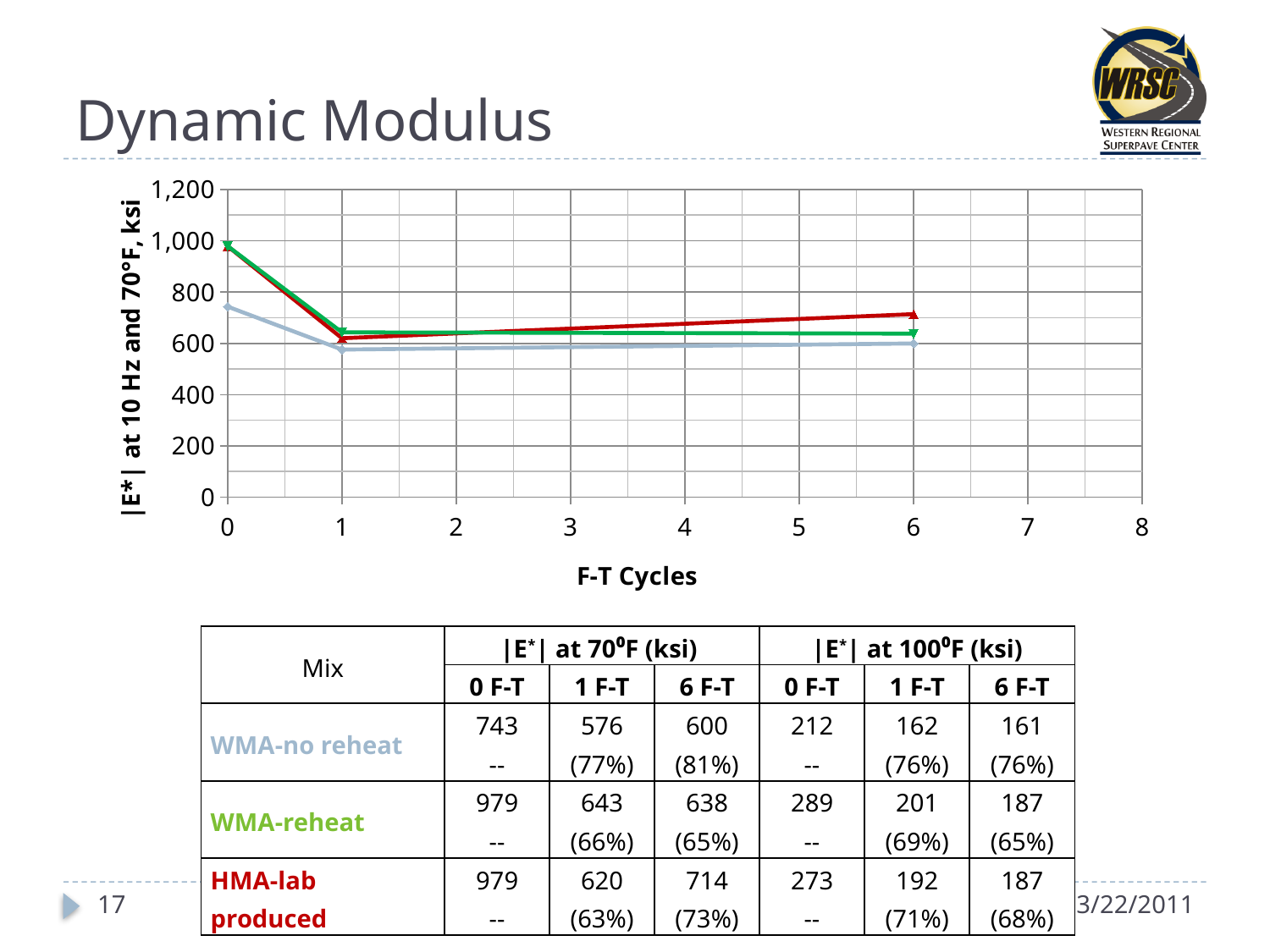
Which line has the highest value at 6 F-T cycles on the chart? the red line (HMA-lab produced) Which line has the lowest value at 1 F-T cycle on the chart? the light blue line (WMA-no reheat) What is the highest tick value shown on the y-axis of the chart? 1,200 What is the x-axis title of the chart? F-T Cycles According to the table, what is |E*| at 70°F for WMA-no reheat at 0 F-T? 743 Is the value of the light blue line at 0 F-T cycles greater or less than 800? less How many lines are plotted on the chart? 3 Is the value of the red line at 6 F-T cycles greater or less than 600? greater What kind of chart is shown on the slide? line chart What is the difference in |E*| at 70°F at 6 F-T between HMA-lab produced and WMA-reheat? 76 Do the plotted values rise or fall between 0 and 1 F-T cycles? fall According to the table, what is |E*| at 70°F for HMA-lab produced at 6 F-T? 714